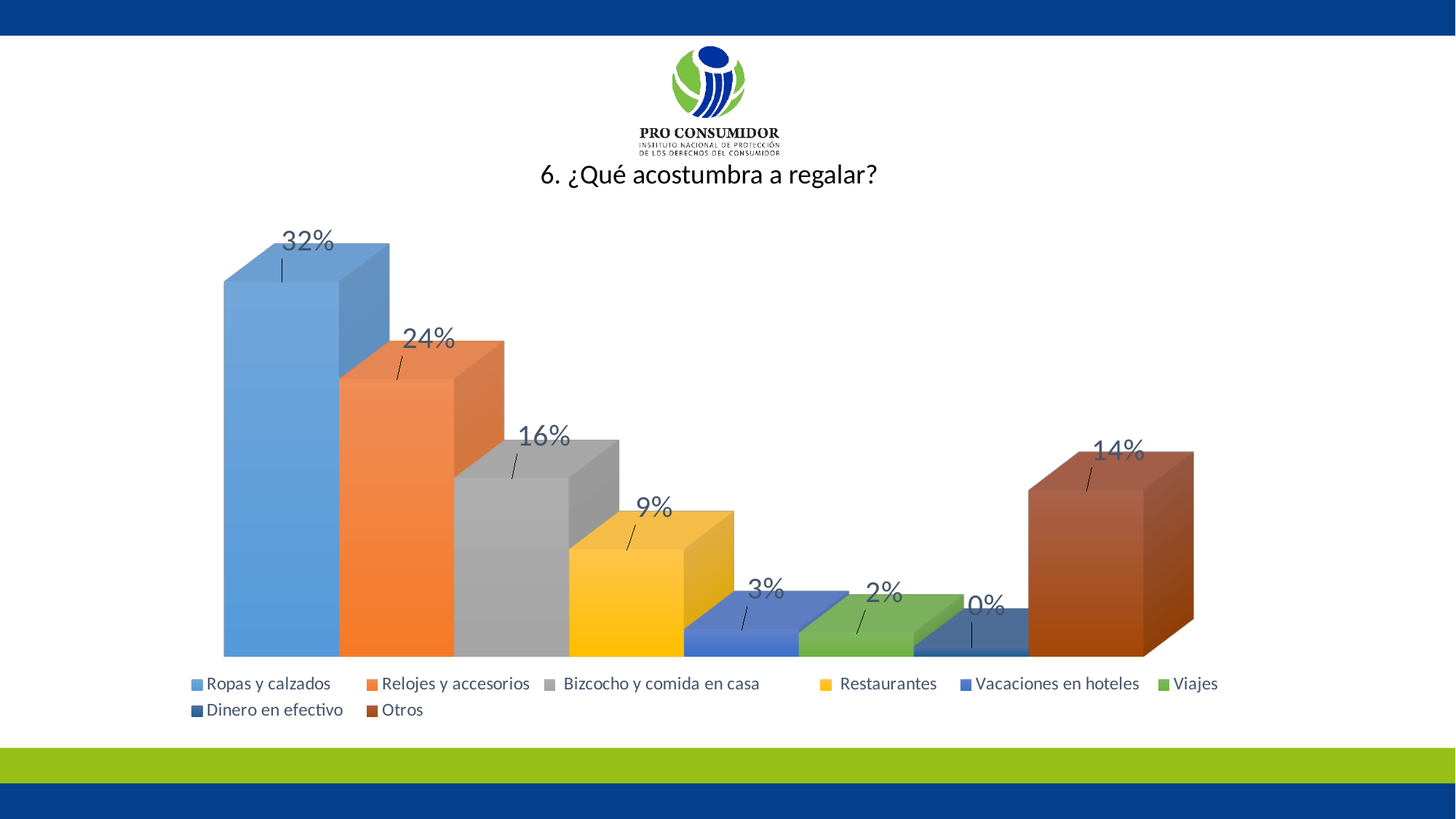
How many categories are shown in the chart? 8 What is the value for Restaurantes? 9% Which category has the lowest value? Dinero en efectivo What is the value for Relojes y accesorios? 24% What is the value for Ropas y calzados? 32% What is the value for Otros? 14% What kind of chart is shown on the slide? Bar chart How many entries does the legend list? 8 What is the title of the chart? 6. ¿Qué acostumbra a regalar? Which is larger, Bizcocho y comida en casa or Otros? Bizcocho y comida en casa What is the difference between Ropas y calzados and Relojes y accesorios? 8% Which category has the highest value? Ropas y calzados